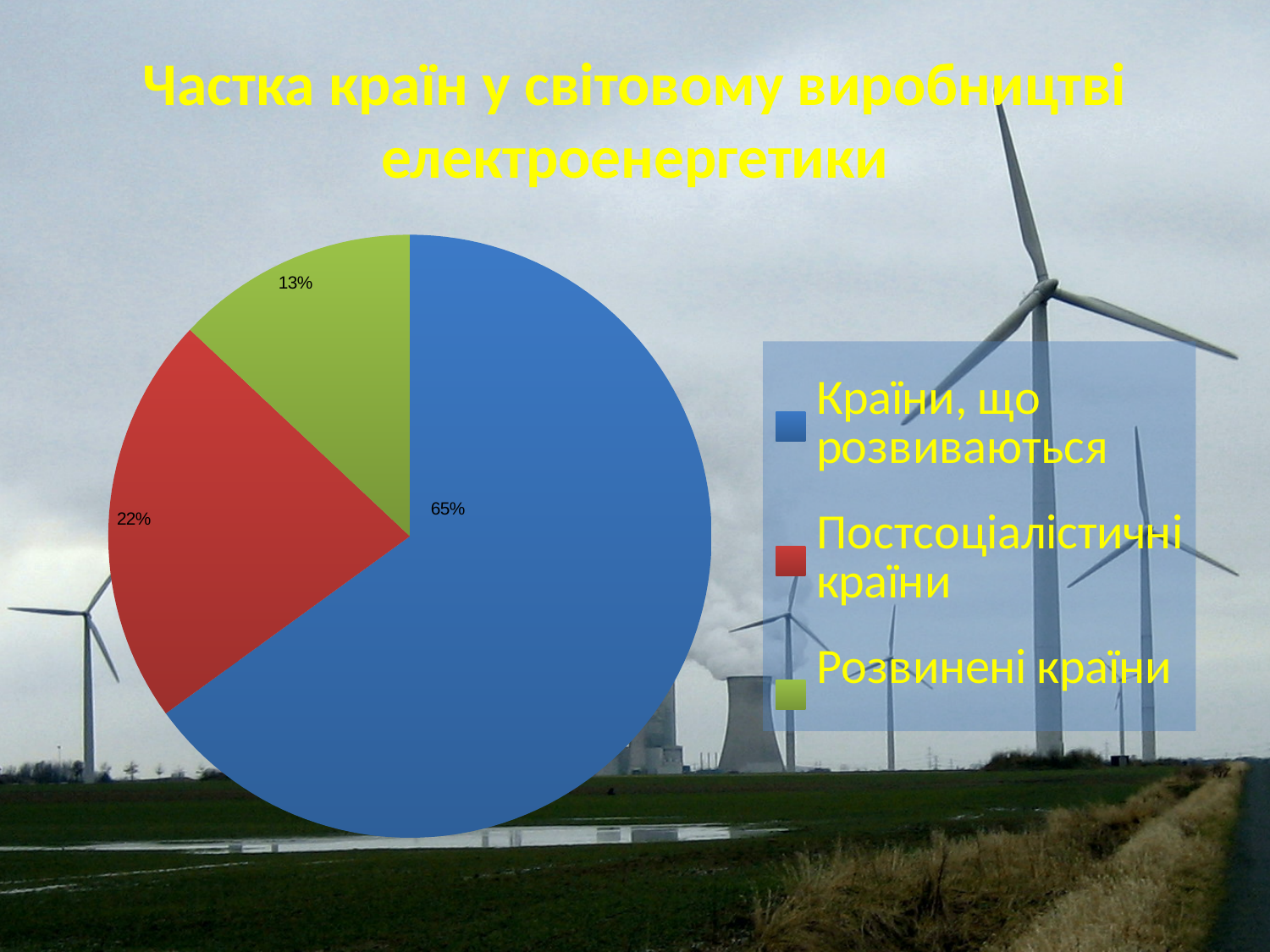
How many slices does the pie chart have? 3 What share of the pie is labelled for 'Розвинені країни'? 13% What is the difference in percentage points between the slices for 'Країни, що розвиваються' and 'Постсоціалістичні країни'? 43 What colour is the slice for 'Розвинені країни'? Green Which category has the largest slice of the pie? Країни, що розвиваються What kind of chart is shown on the slide? Pie chart What is the title of the chart on the slide? Частка країн у світовому виробництві електроенергетики What share of the pie is labelled for 'Країни, що розвиваються'? 65% What is the difference in percentage points between the slices for 'Постсоціалістичні країни' and 'Розвинені країни'? 9 Which slice is larger: 'Постсоціалістичні країни' or 'Розвинені країни'? Постсоціалістичні країни What share of the pie is labelled for 'Постсоціалістичні країни'? 22% Which category has the smallest slice of the pie? Розвинені країни